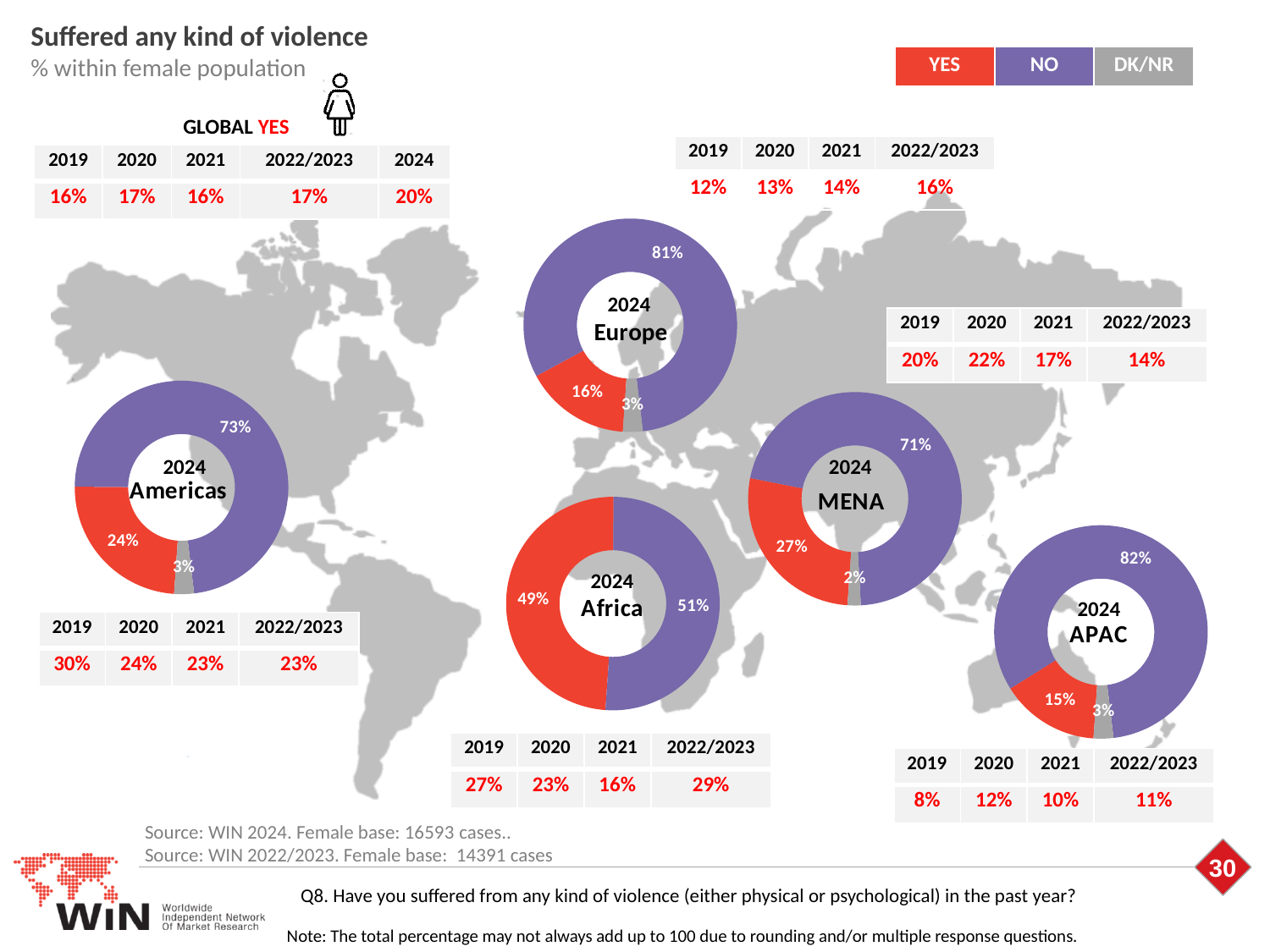
In the 2024 APAC donut chart, what percentage answered NO? 82% In the 2024 Europe donut chart, what percentage answered YES? 16% In the 2024 Africa donut chart, what percentage answered YES? 49% Comparing the 2024 donut charts, is the YES share larger for the Americas or for Europe? Americas Across the five 2024 regional donut charts, which region has the lowest YES share? APAC In the 2024 MENA donut chart, what percentage answered DK/NR? 2% Across the five 2024 regional donut charts, which region has the highest YES share? Africa What type of chart is used to show the 2024 results for each region? Donut (pie) chart In the 2024 MENA donut chart, what is the difference between the NO and YES shares? 44% How many response categories does the legend at the top right list? 3 In the 2024 Americas donut chart, what percentage answered NO? 73% How many regional donut charts are shown on the slide? 5